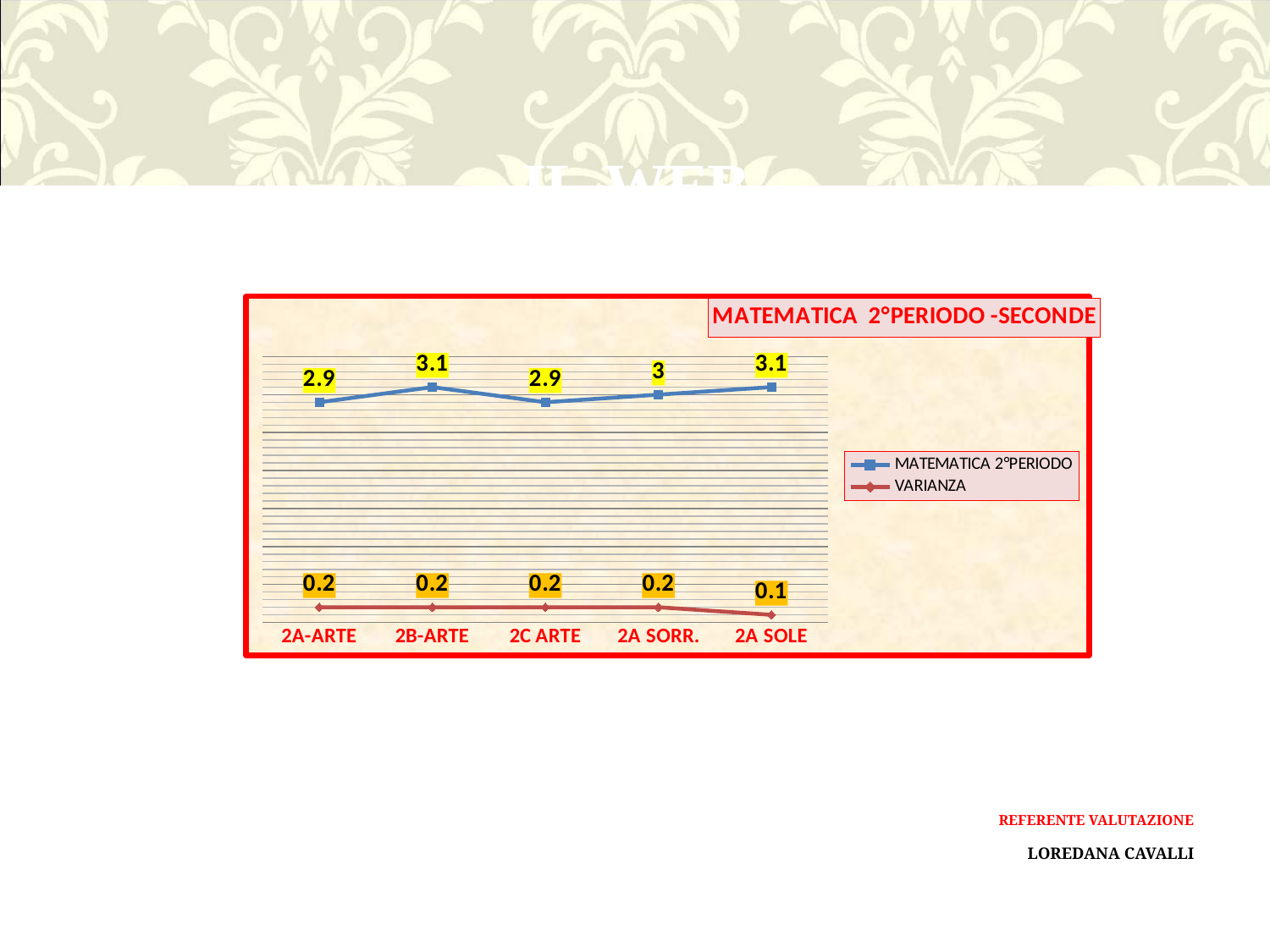
What kind of chart is shown on the slide? Line chart How many categories are shown on the x axis? 5 What is the MATEMATICA 2°PERIODO value for 2A SORR.? 3 Which category has the lowest VARIANZA value? 2A SOLE What is the MATEMATICA 2°PERIODO value for 2A-ARTE? 2.9 What is the VARIANZA value for 2A SOLE? 0.1 Which is larger, the MATEMATICA 2°PERIODO value for 2A SORR. or for 2A SOLE? 2A SOLE What is the title of the chart? MATEMATICA 2°PERIODO -SECONDE What is the VARIANZA value for 2B-ARTE? 0.2 What colour is the VARIANZA line in the chart? Red What is the difference between the MATEMATICA 2°PERIODO values for 2B-ARTE and 2C ARTE? 0.2 How many series does the legend list? 2